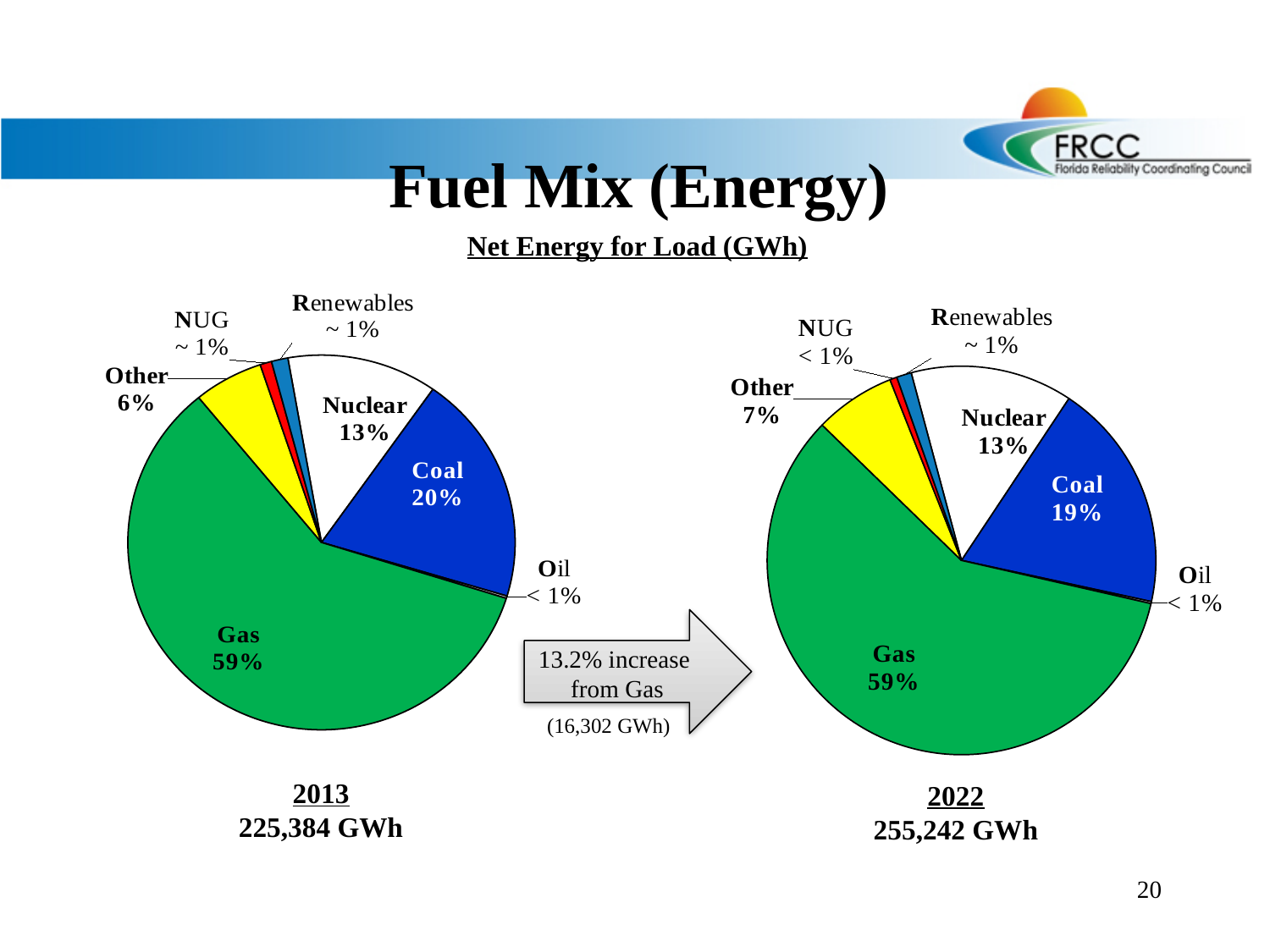
In the 2022 pie chart, which fuel has the largest share? Gas In the 2013 pie chart, how many percentage points larger is the Gas share than the Coal share? 39 percentage points In the 2022 pie chart, which is larger, the Coal share or the Nuclear share? Coal In the 2013 pie chart, what share of net energy for load comes from Gas? 59% In the 2022 pie chart, what share of net energy for load comes from Coal? 19% In the 2022 pie chart, what is the share for Nuclear? 13% How many fuel categories are shown in the 2013 pie chart? 7 What total net energy for load is shown under the 2013 pie chart? 225,384 GWh What total net energy for load is shown under the 2022 pie chart? 255,242 GWh In the 2013 pie chart, which fuel has the largest share? Gas What kind of chart is used to show the fuel mix for 2013 and 2022? Pie chart In the 2013 pie chart, what is the share for Other? 6%